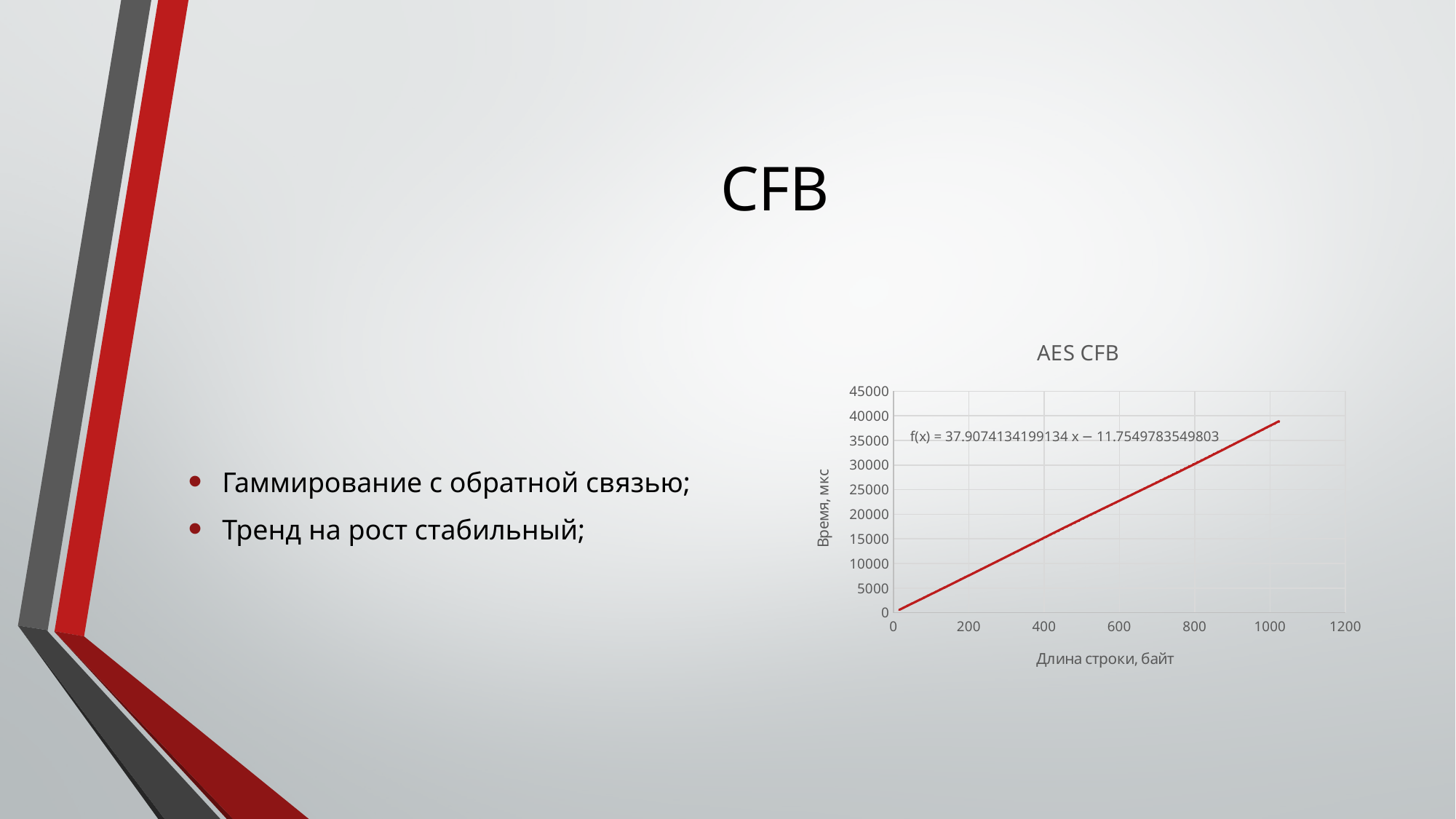
What is the slope coefficient in the trendline equation shown on the chart? 37.9074134199134 What is the highest tick value shown on the x axis of the chart? 1200 Is the value of the line at a string length of 200 bytes greater or less than 5000? greater What kind of chart is shown on the slide? line chart What is the label of the x axis of the chart? Длина строки, байт What is the highest tick value shown on the y axis of the chart? 45000 Does the plotted time rise or fall as the string length increases along the x axis? rise Is the value of the line at a string length of 1000 bytes greater or less than 35000? greater Is the value of the line at a string length of 200 bytes greater or less than 10000? less What is the title of the chart? AES CFB What is the constant term in the trendline equation shown on the chart? − 11.7549783549803